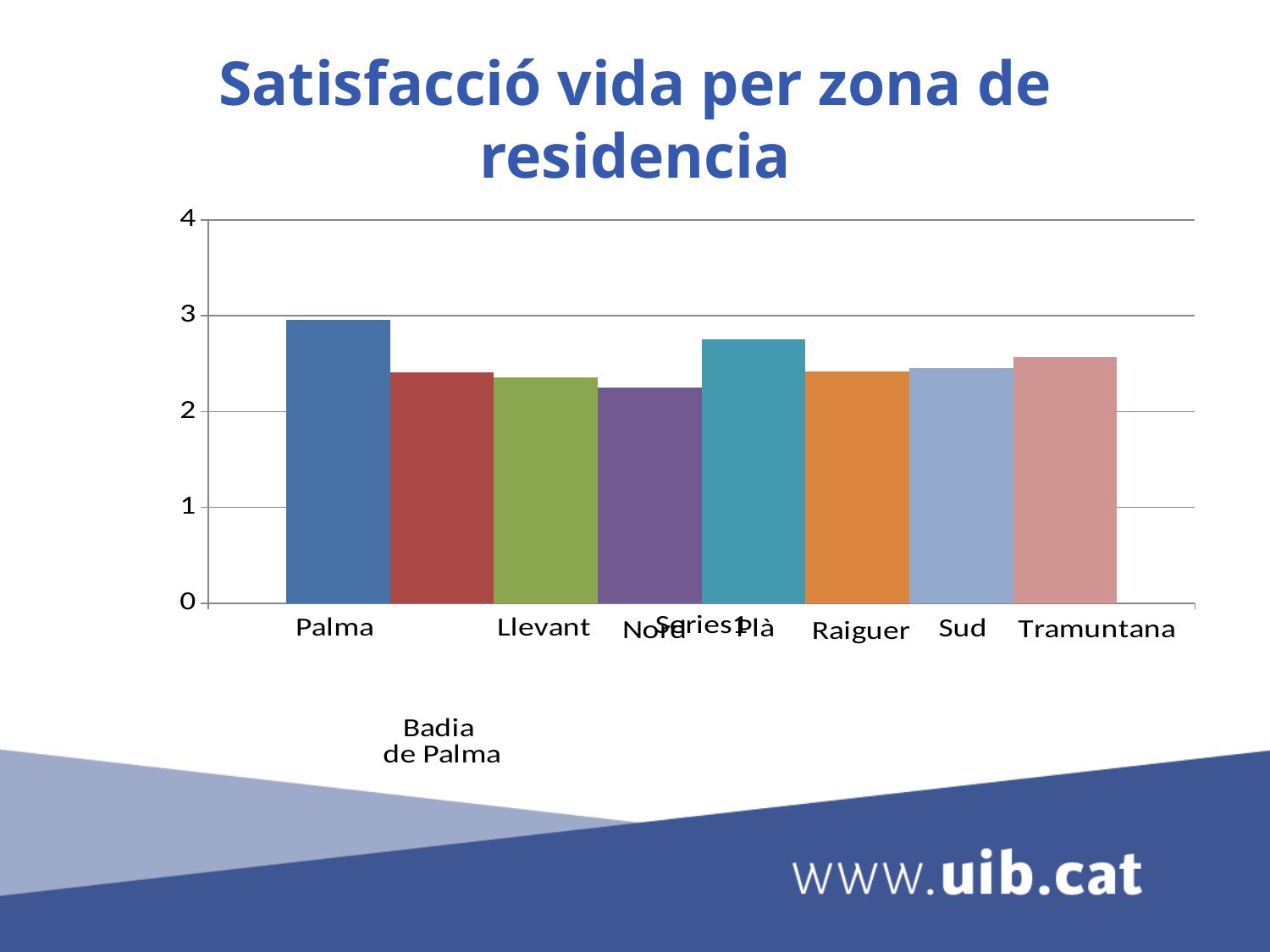
What kind of chart is shown on the slide? bar chart How many zones (categories) are plotted in the chart? 8 Which is larger, the value for Plà or the value for Llevant? Plà Which is larger, the value for Palma or the value for Plà? Palma Is the value for Nord greater or less than 2? greater Is the value for Tramuntana greater or less than 2? greater What is the title of the chart? Satisfacció vida per zona de residencia Is the value for Plà greater or less than 3? less Which is larger, the value for Tramuntana or the value for Nord? Tramuntana Which zone has the highest life satisfaction value? Palma Which zone has the lowest life satisfaction value? Nord